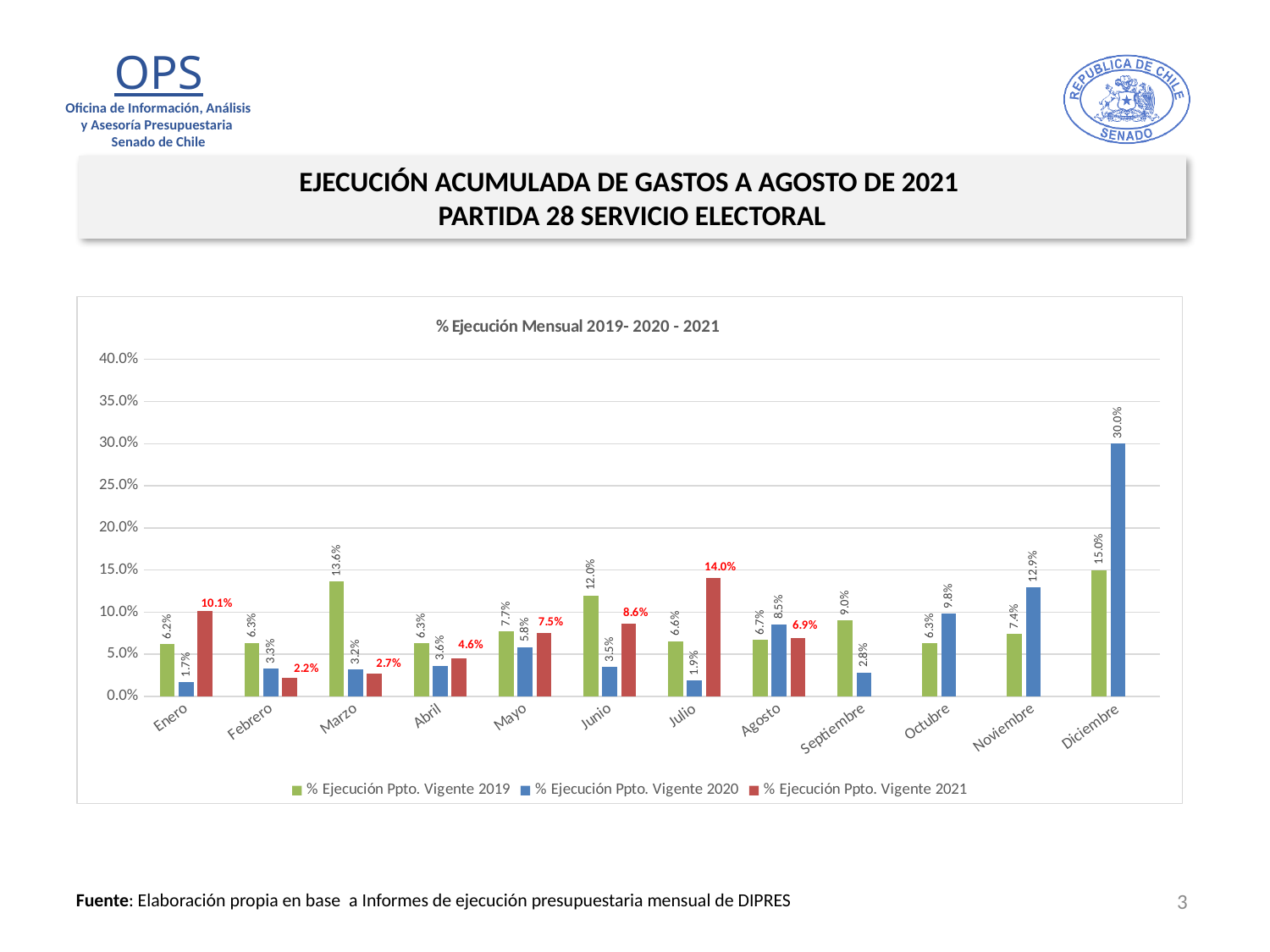
How many series does the legend list? 3 What kind of chart is shown on the slide? Bar chart What is the value for % Ejecución Ppto. Vigente 2021 in Julio? 14.0% Is the value for % Ejecución Ppto. Vigente 2020 in Diciembre greater or less than 25.0%? greater How many months are shown on the x axis? 12 What is the value for % Ejecución Ppto. Vigente 2021 in Enero? 10.1% Which month has the lowest value for % Ejecución Ppto. Vigente 2021? Febrero What is the value for % Ejecución Ppto. Vigente 2019 in Marzo? 13.6% What is the value for % Ejecución Ppto. Vigente 2020 in Diciembre? 30.0% Which month has the highest value for % Ejecución Ppto. Vigente 2020? Diciembre What is the difference between the 2021 and 2020 values in Julio? 12.1% In Agosto, which series has the larger value: % Ejecución Ppto. Vigente 2020 or % Ejecución Ppto. Vigente 2021? % Ejecución Ppto. Vigente 2020